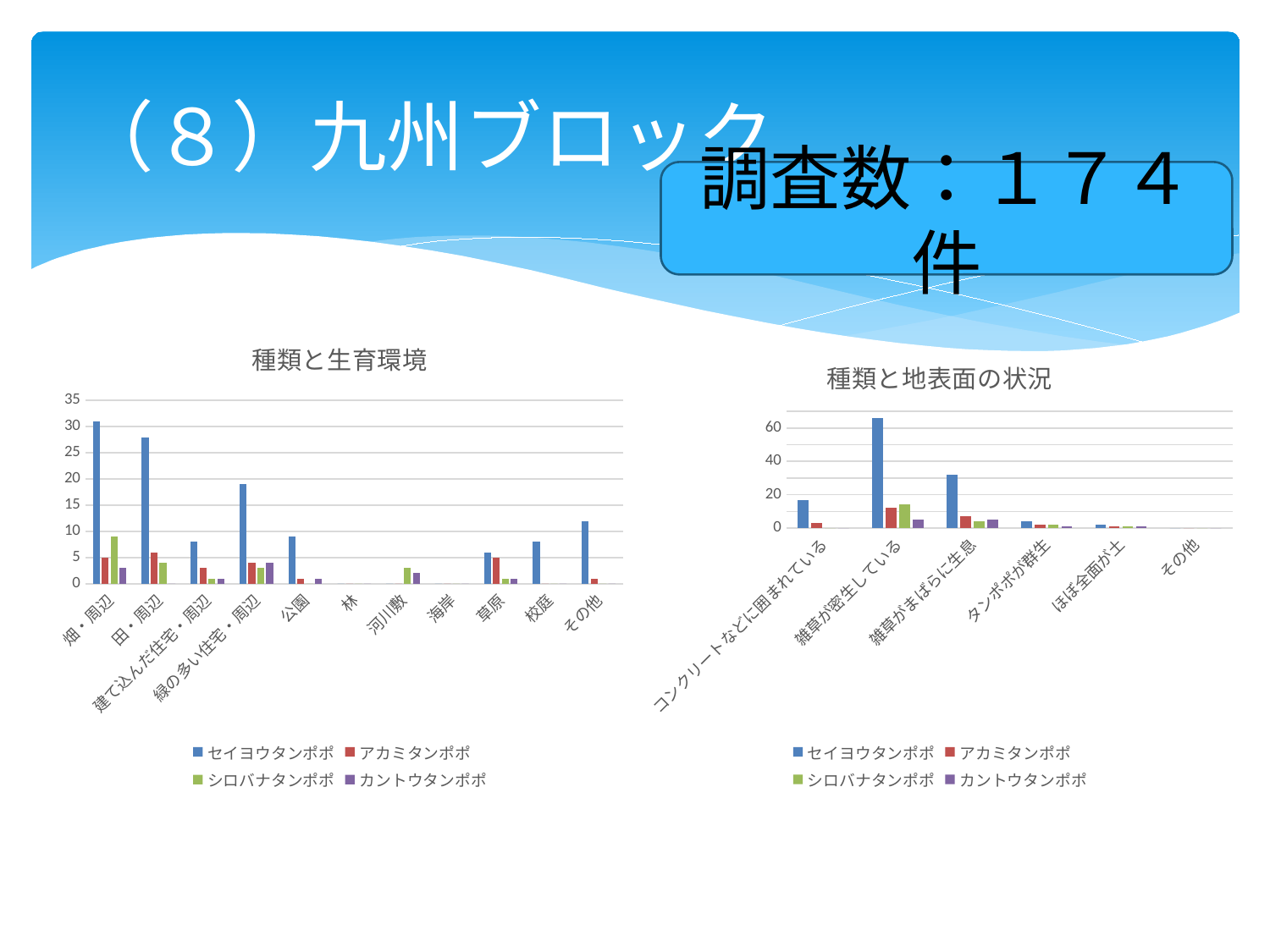
How many series does the legend of the right chart (種類と地表面の状況) list? 4 What is the title of the right chart on the slide? 種類と地表面の状況 How many categories are shown on the x axis of the left chart (種類と生育環境)? 11 In the right chart (種類と地表面の状況), which is larger for セイヨウタンポポ: 雑草が密生している or 雑草がまばらに生息? 雑草が密生している What kind of chart is the left chart titled 種類と生育環境? bar chart In the right chart (種類と地表面の状況), which category has the highest value for セイヨウタンポポ? 雑草が密生している In the left chart (種類と生育環境), is the value of セイヨウタンポポ for 田・周辺 greater or less than 25? greater In the right chart (種類と地表面の状況), is the value of セイヨウタンポポ for 雑草が密生している greater or less than 60? greater In the left chart (種類と生育環境), is the value of セイヨウタンポポ for 公園 greater or less than 10? less In the left chart (種類と生育環境), which is larger for セイヨウタンポポ: 緑の多い住宅・周辺 or 校庭? 緑の多い住宅・周辺 In the left chart (種類と生育環境), which category has the highest value for セイヨウタンポポ? 畑・周辺